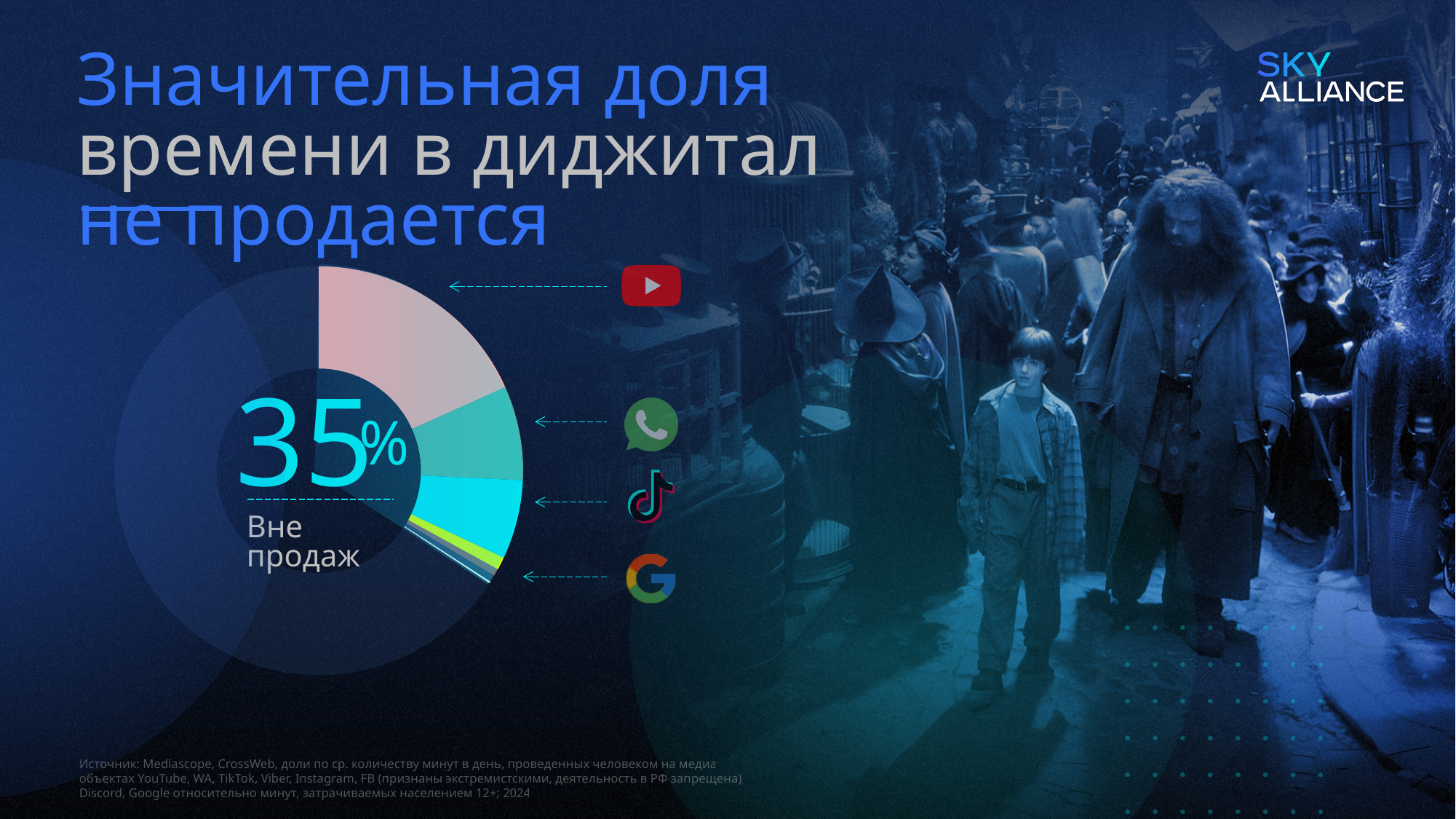
What label accompanies the 35% value in the centre of the pie chart? Вне продаж Which slice is larger in the pie chart: WhatsApp or Google? WhatsApp Which platform's slice is the largest among the icon-labelled slices of the pie chart? YouTube What percentage is printed in the centre of the pie chart? 35% What kind of chart is shown on the slide? doughnut chart Which platform's slice is the smallest among the icon-labelled slices of the pie chart? Google How many platform icons label slices of the pie chart? 4 What is the title of the slide containing the pie chart? Значительная доля времени в диджитал не продается Which slice is larger in the pie chart: TikTok or Google? TikTok Which platform icon is connected to the pink slice of the pie chart? YouTube Which slice is larger in the pie chart: YouTube or WhatsApp? YouTube